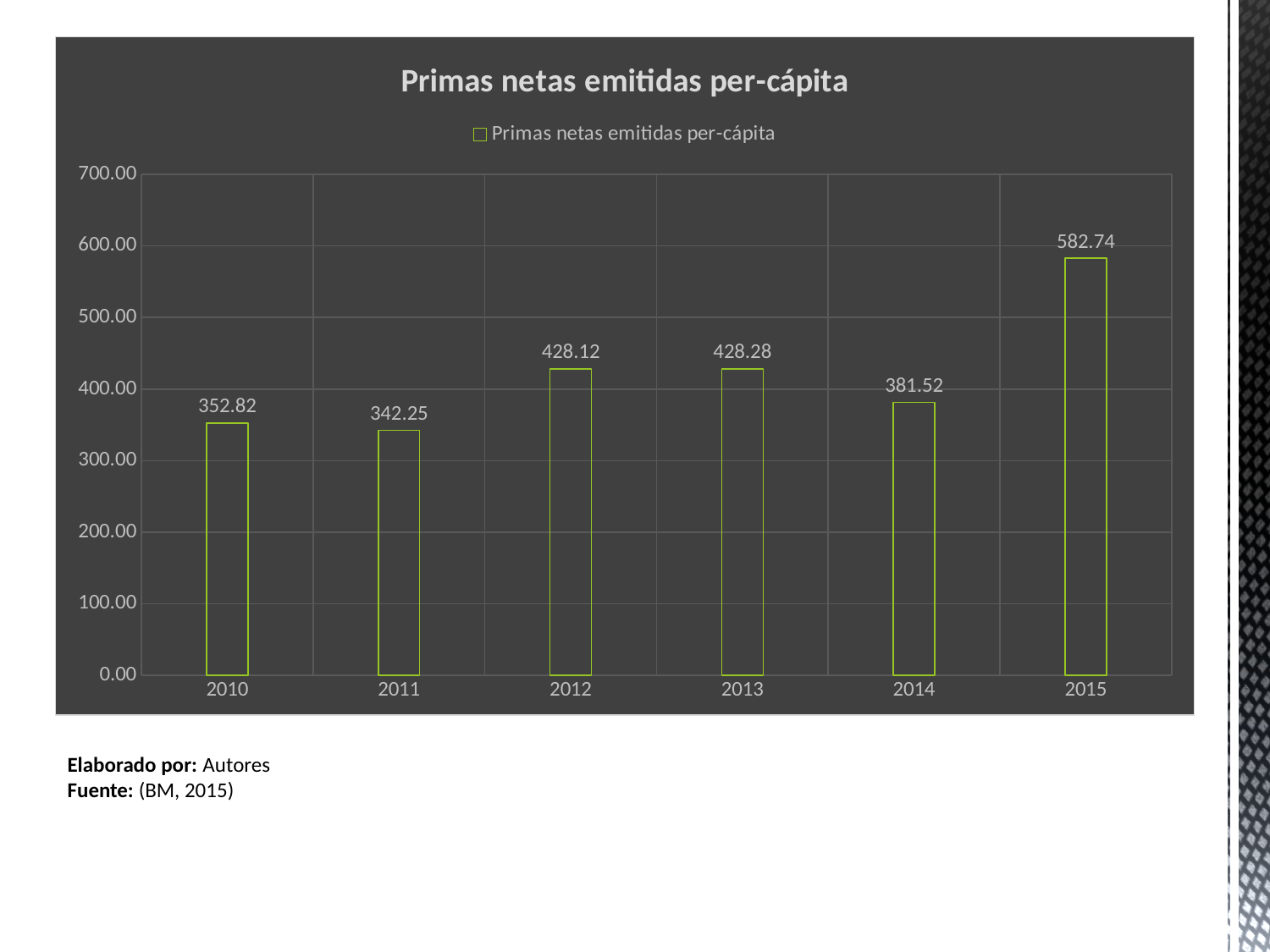
What is the difference between the values for 2010 and 2011? 10.57 Which year has the lowest value? 2011 What is the difference between the values for 2015 and 2014? 201.22 What is the title of the chart? Primas netas emitidas per-cápita How many years are shown on the x axis? 6 What is the value for 2015? 582.74 Which year has the highest value? 2015 Is the value for 2013 greater or less than 400.00? greater What kind of chart is this? bar chart What is the value for 2010? 352.82 What is the value for 2014? 381.52 Which is larger, the value for 2012 or the value for 2014? 2012